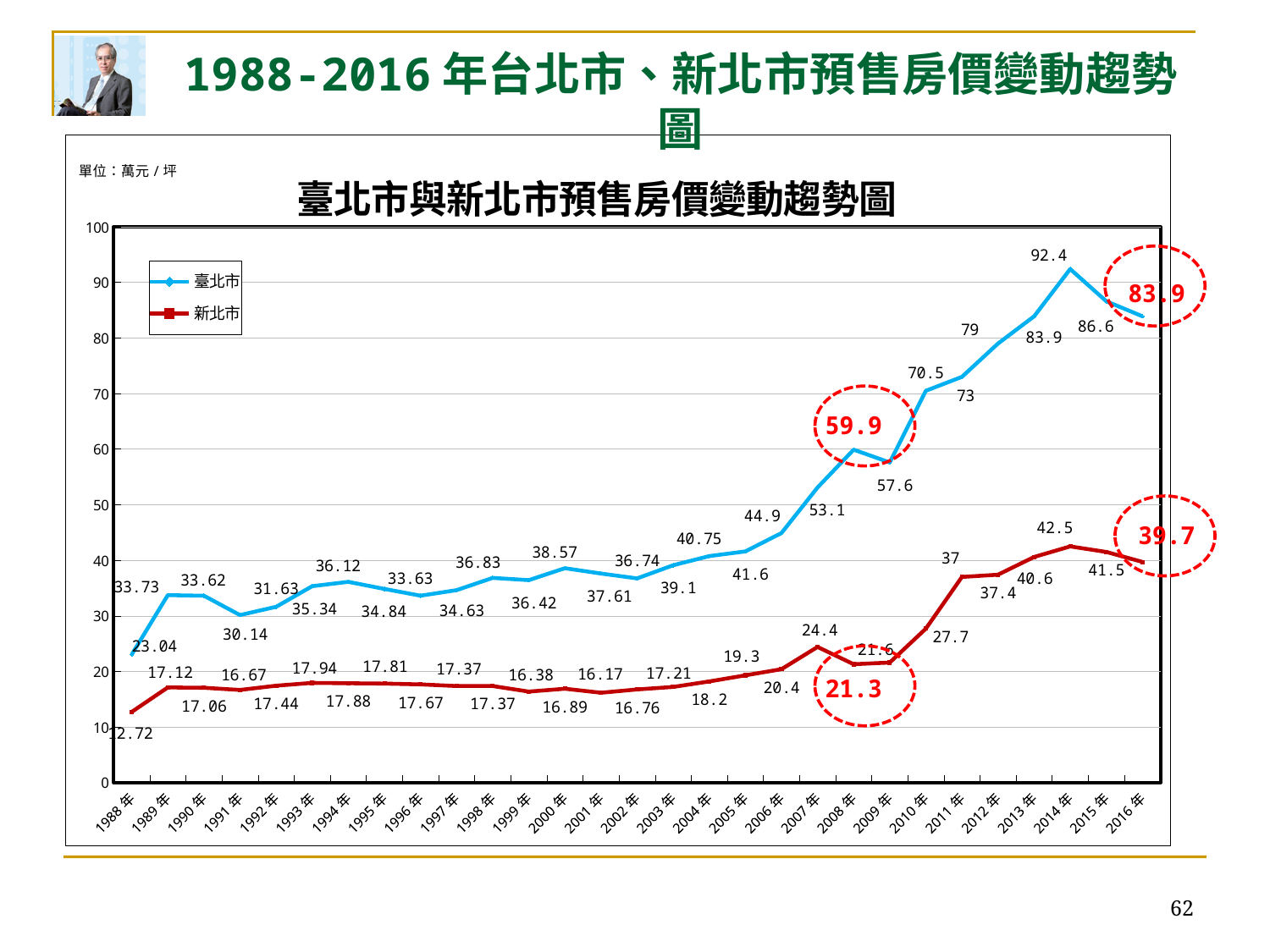
In which year does the 臺北市 series reach its highest value? 2014年 What kind of chart is shown? Line chart In which year is the 新北市 series at its lowest value? 1988年 What unit is stated for the values in the chart? 萬元/坪 How many years are plotted on the x axis? 29 What is the value for 新北市 in 2016年? 39.7 Which series has the larger value in 2008年, 臺北市 or 新北市? 臺北市 What is the value for 臺北市 in 2014年? 92.4 How many series does the legend list? 2 What is the value for 臺北市 in 2008年? 59.9 What is the difference between the 臺北市 and 新北市 values in 2016年? 44.2 Does the 臺北市 series generally rise or fall from 1988年 to 2014年? Rise